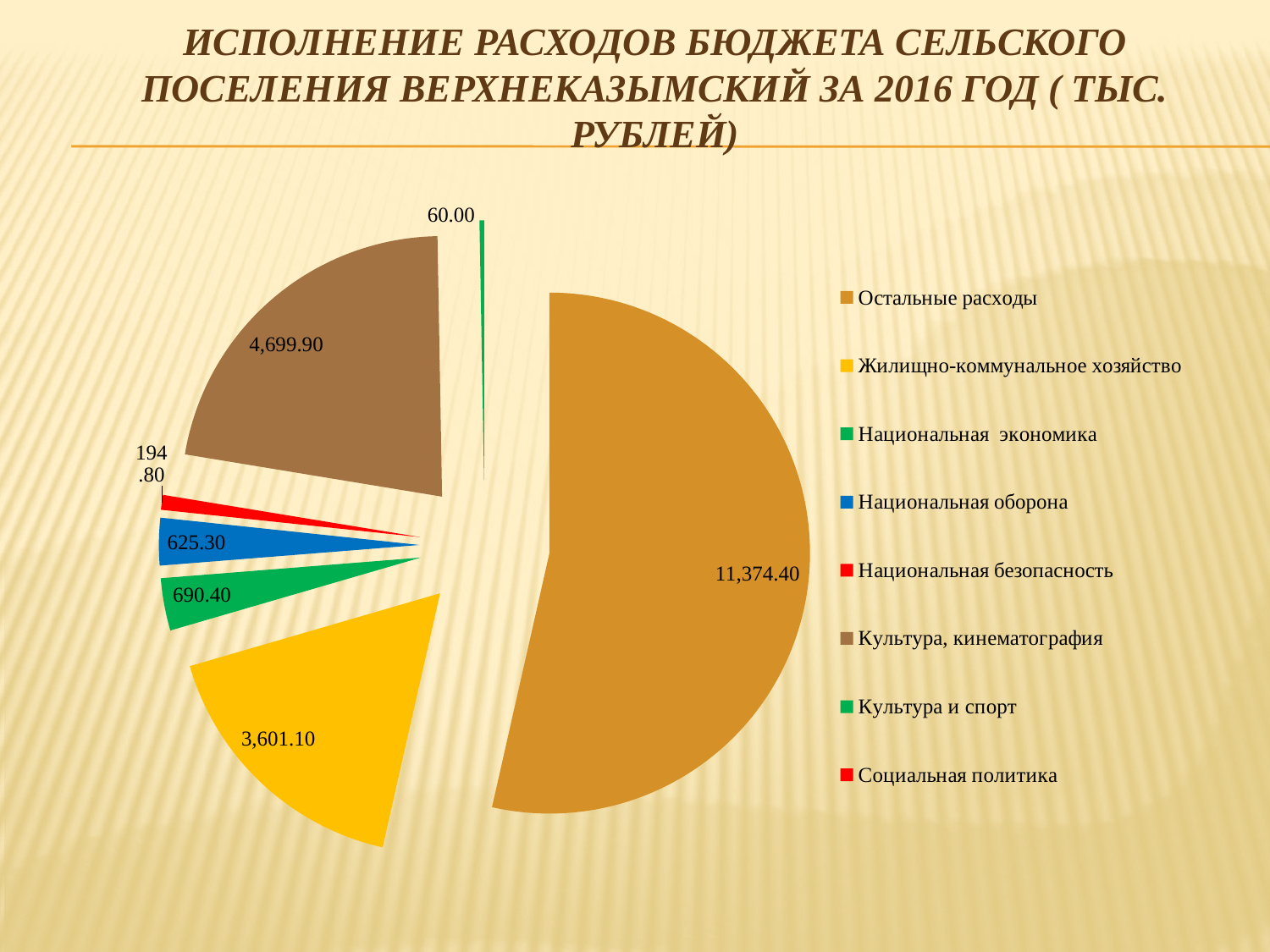
How many categories does the legend list? 8 What is the value for Культура, кинематография? 4,699.90 What is the value for Национальная оборона? 625.30 Which is larger, the value for Национальная экономика or the value for Национальная оборона? Национальная экономика What is the value for Национальная экономика? 690.40 What is the difference between the values for Культура, кинематография and Жилищно-коммунальное хозяйство? 1,098.80 What is the value for Жилищно-коммунальное хозяйство? 3,601.10 What is the value for Остальные расходы? 11,374.40 What colour is the slice for Остальные расходы? orange Which category has the largest slice of the pie? Остальные расходы What is the value for Культура и спорт? 60.00 What kind of chart is shown on the slide? pie chart